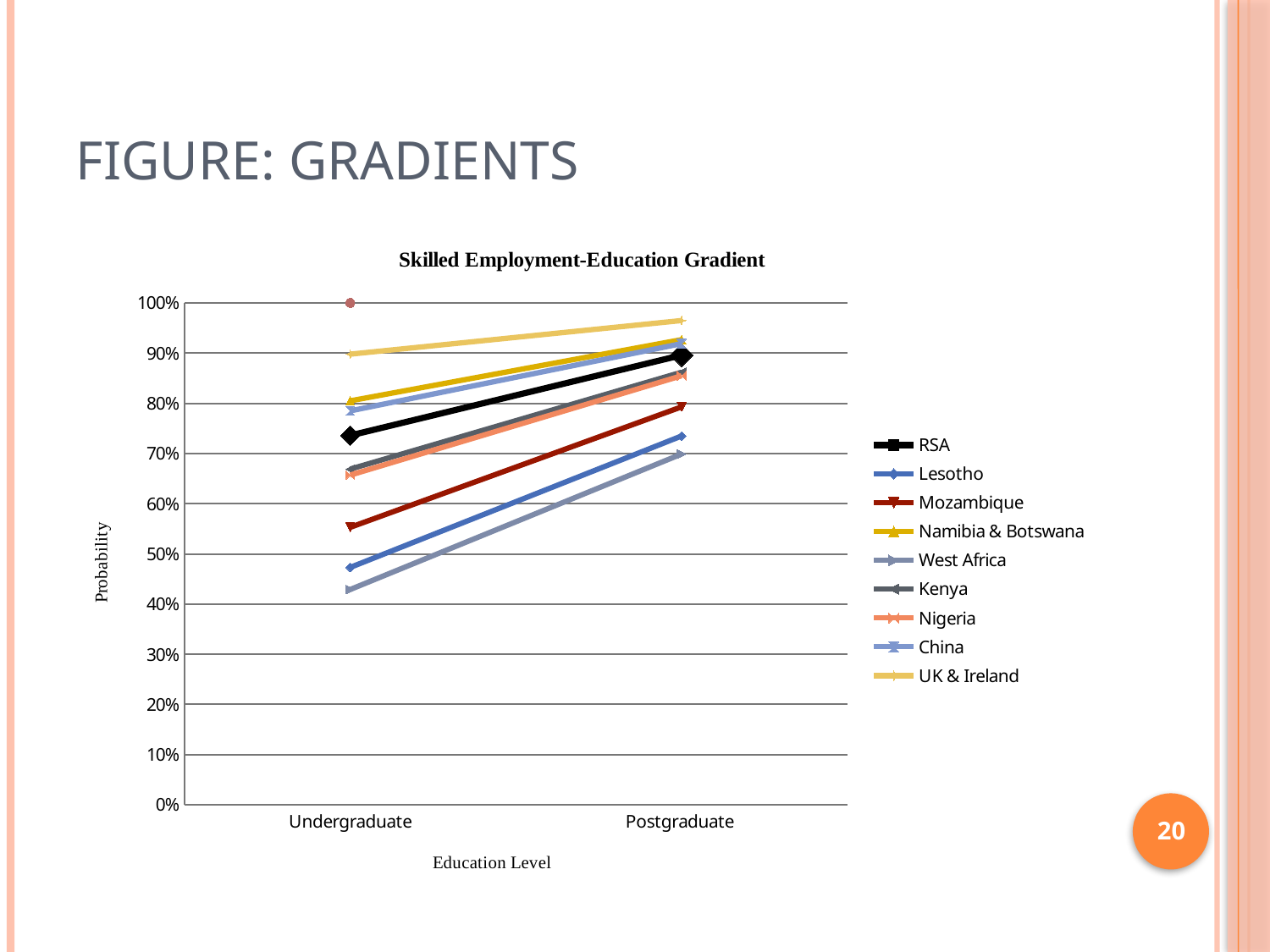
Is the value for Lesotho at Undergraduate greater or less than 50%? less Which is larger at Undergraduate, Mozambique or Lesotho? Mozambique What kind of chart is shown on the slide? line chart How many series does the legend list? 9 How many education levels are shown on the x axis? 2 What is the title of the chart? Skilled Employment-Education Gradient Do the values for RSA rise or fall from Undergraduate to Postgraduate? rise Which series has the highest value at Postgraduate? UK & Ireland Is the value for RSA at Undergraduate greater or less than 70%? greater Which series has the highest value at Undergraduate? UK & Ireland Which series has the lowest value at Undergraduate? West Africa What is the label on the vertical axis? Probability